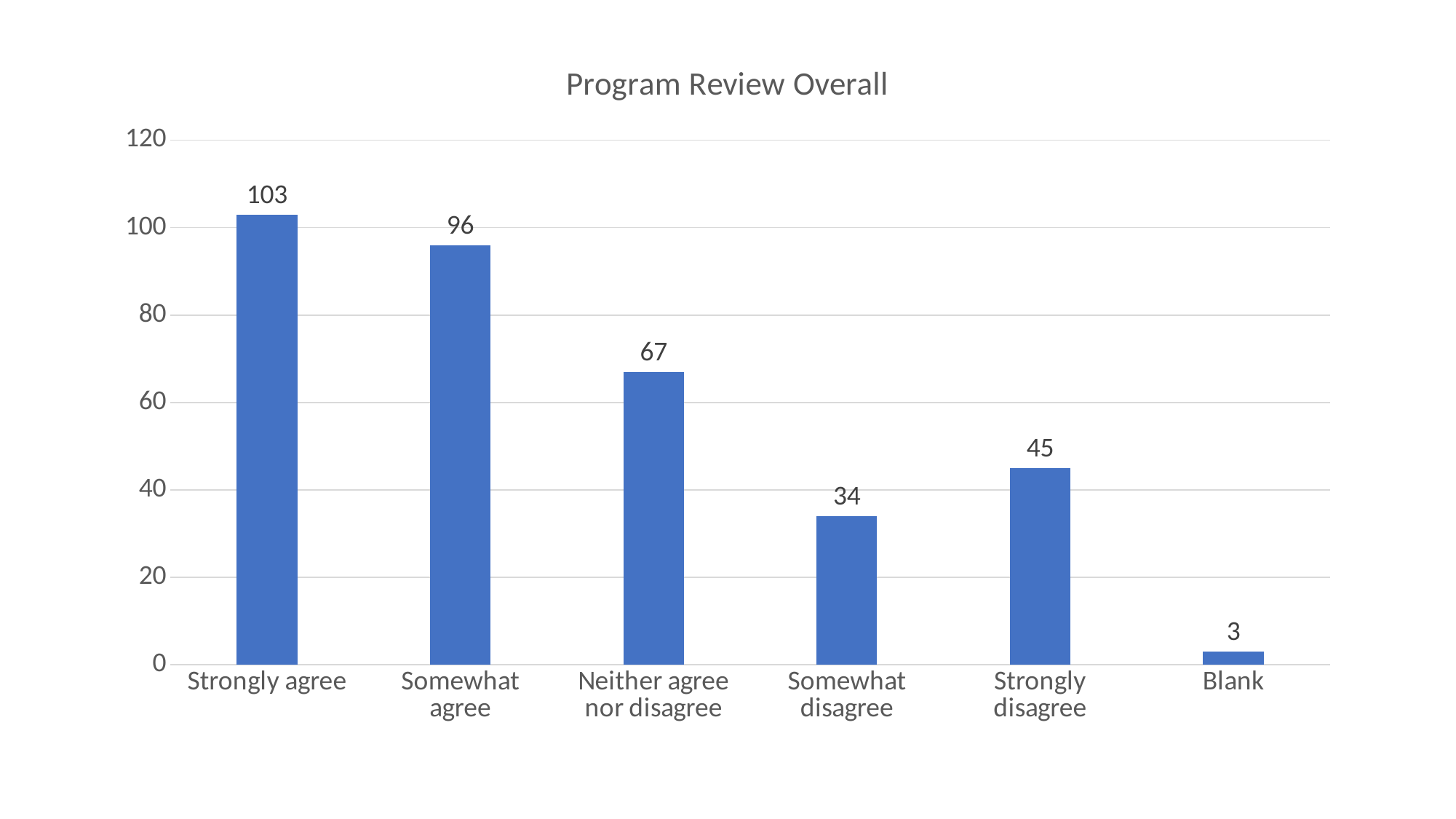
What is the difference between Strongly disagree and Somewhat disagree? 11 Is the value for Neither agree nor disagree greater or less than 60? greater What is the value for Neither agree nor disagree? 67 What kind of chart is this? bar chart What is the value for Blank? 3 Which is larger, Somewhat disagree or Strongly disagree? Strongly disagree Which category has the highest value? Strongly agree What is the value for Strongly agree? 103 How many categories are shown on the x axis? 6 Which category has the lowest value? Blank What is the title of the chart? Program Review Overall What is the difference between Strongly agree and Somewhat agree? 7